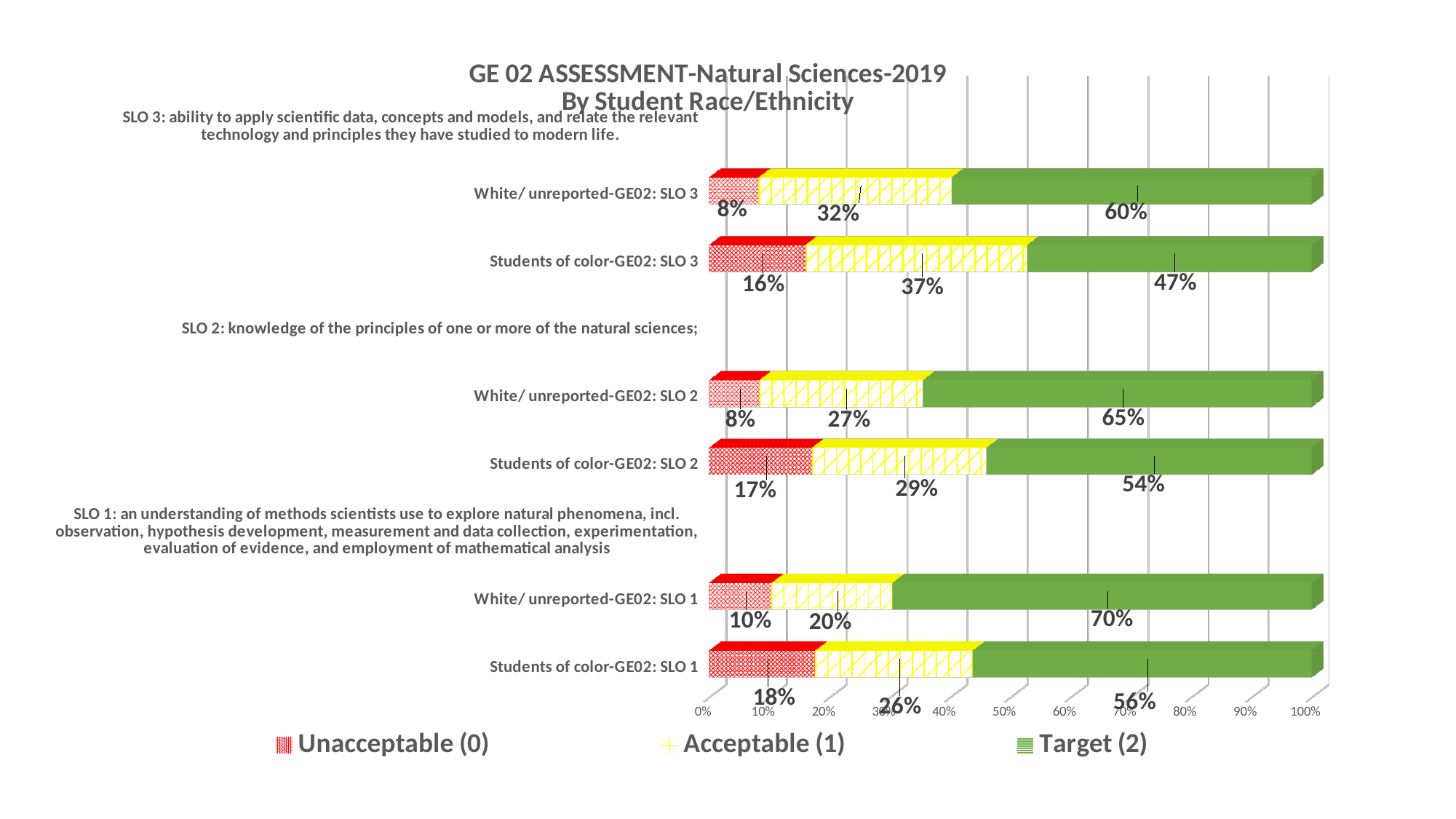
What is the Unacceptable (0) value for Students of color-GE02: SLO 2? 17% How many series does the legend list? 3 Which category has the highest Unacceptable (0) value? Students of color-GE02: SLO 1 What kind of chart is shown on the slide? Stacked bar chart What is the total of the stacked bar for Students of color-GE02: SLO 1? 100% What is the Acceptable (1) value for Students of color-GE02: SLO 3? 37% How many bars (categories) are plotted in the chart? 6 What is the difference between the Target (2) values for White/ unreported-GE02: SLO 3 and Students of color-GE02: SLO 3? 13 percentage points Which category has the lowest Target (2) value? Students of color-GE02: SLO 3 Which is larger: the Acceptable (1) value for White/ unreported-GE02: SLO 3 or for Students of color-GE02: SLO 2? White/ unreported-GE02: SLO 3 What is the Target (2) value for White/ unreported-GE02: SLO 1? 70% Which category has the highest Target (2) value? White/ unreported-GE02: SLO 1